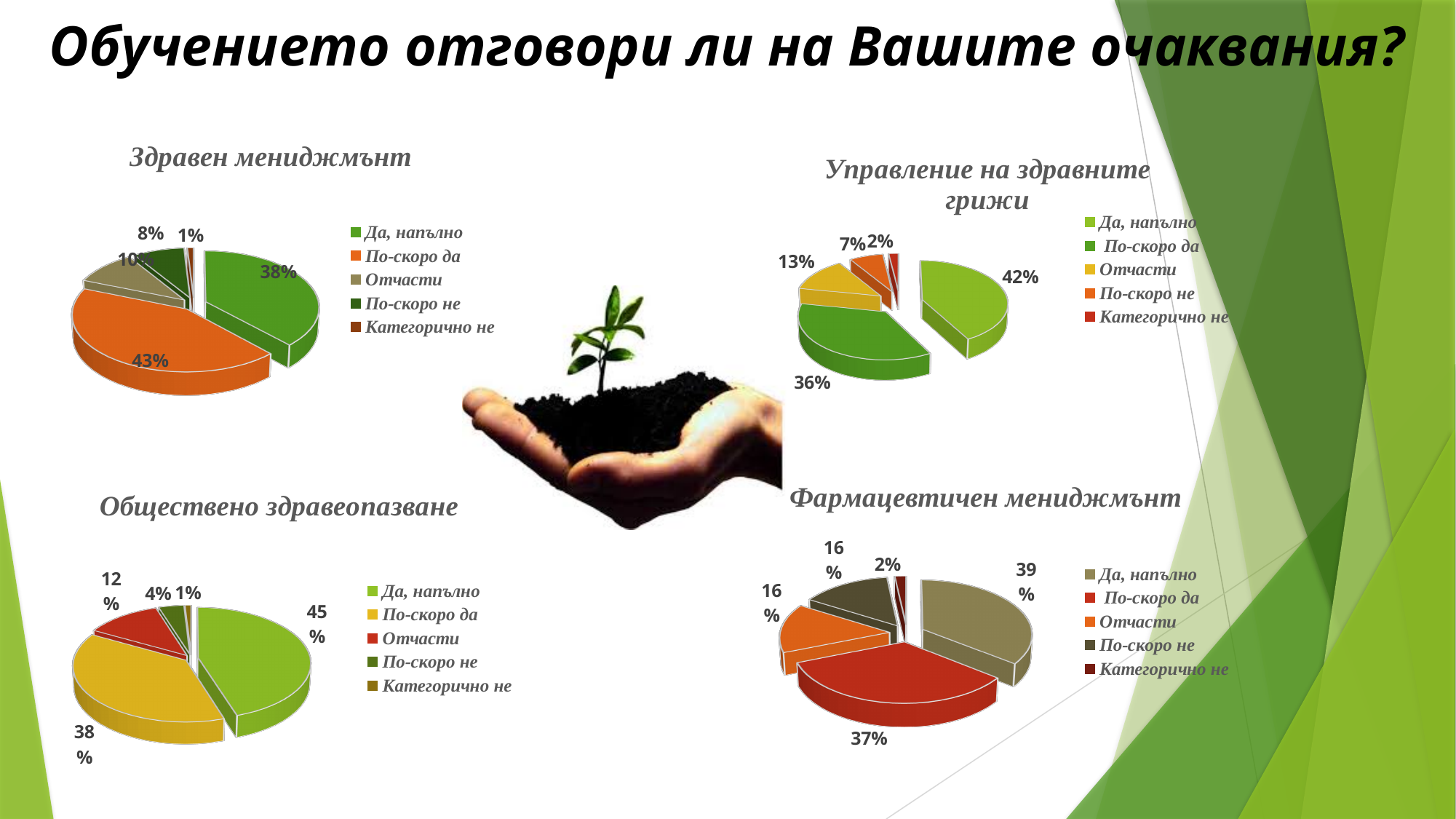
How many charts are on the slide, and what type are they? 4 pie charts In the "Управление на здравните грижи" chart, what percentage is shown for "Да, напълно"? 42% In the "Фармацевтичен мениджмънт" chart, which category has the smallest share? Категорично не In the "Обществено здравеопазване" chart, what percentage is shown for "Да, напълно"? 45% In the "Фармацевтичен мениджмънт" chart, what percentage is shown for "По-скоро да"? 37% In the "Здравен мениджмънт" chart, what percentage is shown for "По-скоро да"? 43% In the "Здравен мениджмънт" chart, what is the difference between the "По-скоро да" and "Да, напълно" shares? 5% In the "Здравен мениджмънт" chart, which category has the largest share? По-скоро да In the "Управление на здравните грижи" chart, which category has the smallest share? Категорично не In the "Обществено здравеопазване" chart, what is the difference between the "Да, напълно" and "По-скоро да" shares? 7% How many entries does the legend of the "Обществено здравеопазване" chart list? 5 In the "Управление на здравните грижи" chart, which is larger: "Отчасти" or "По-скоро не"? Отчасти